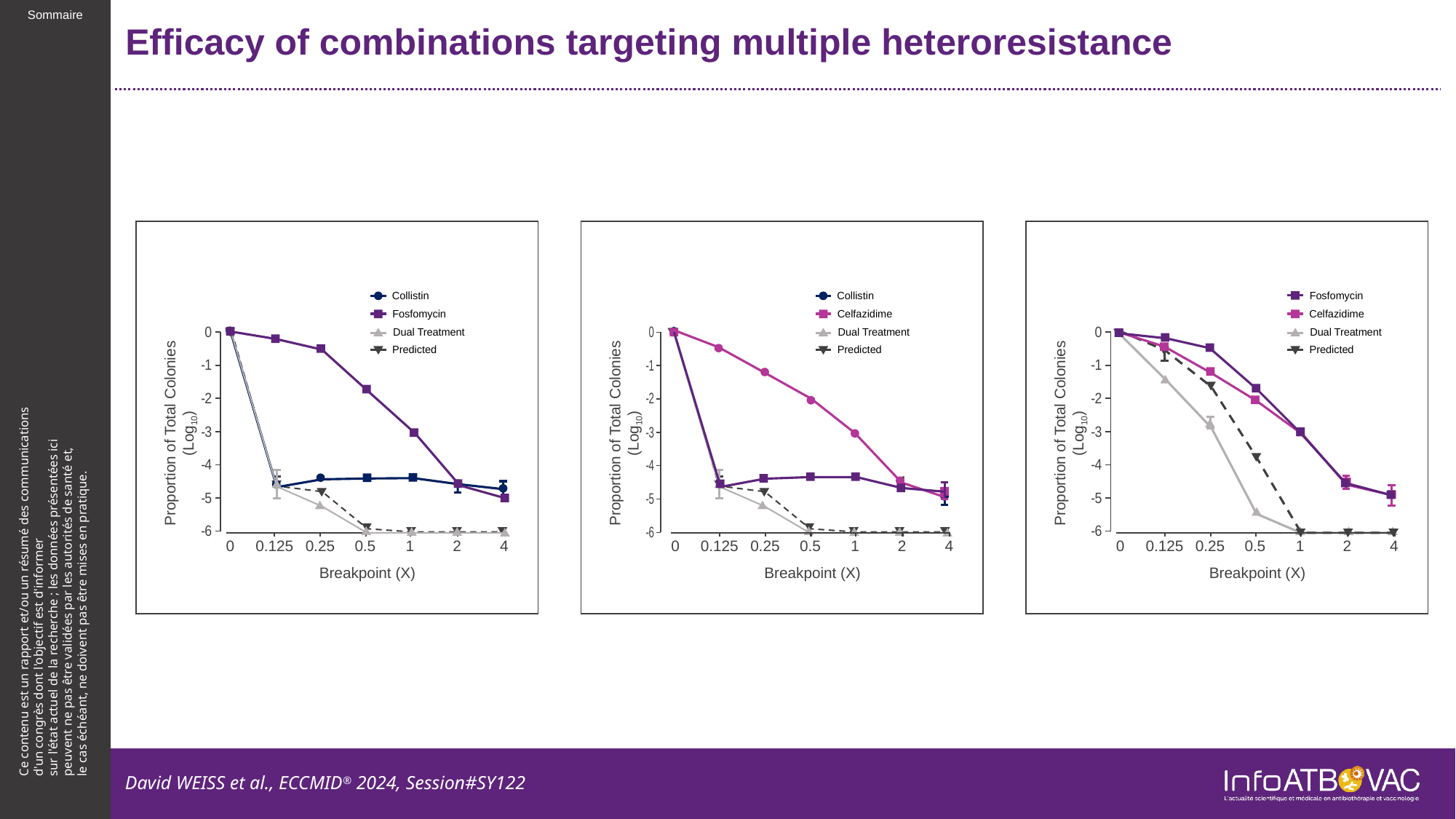
In the left chart, is the value for Collistin at breakpoint 0.125 greater or less than -4? less In the left chart, at breakpoint 0.5, which is higher: Fosfomycin or Collistin? Fosfomycin In the left chart, how many series does the legend list? 4 In the right chart, which series are listed in the legend? Fosfomycin, Celfazidime, Dual Treatment, Predicted In the middle chart, what is the value for Celfazidime at breakpoint 0? 0 In the right chart, which series has the lowest value at breakpoint 0.5? Dual Treatment In the middle chart, is the value for Celfazidime at breakpoint 0.5 greater or less than -1? less What kind of chart is the left chart on the slide? line chart In the left chart, does the Fosfomycin series rise or fall as the breakpoint increases? fall In the right chart, how many breakpoint values are marked on the x axis? 7 In the left chart, what is the value for Fosfomycin at breakpoint 1? -3 In the middle chart, which series has the highest value at breakpoint 0.25? Celfazidime